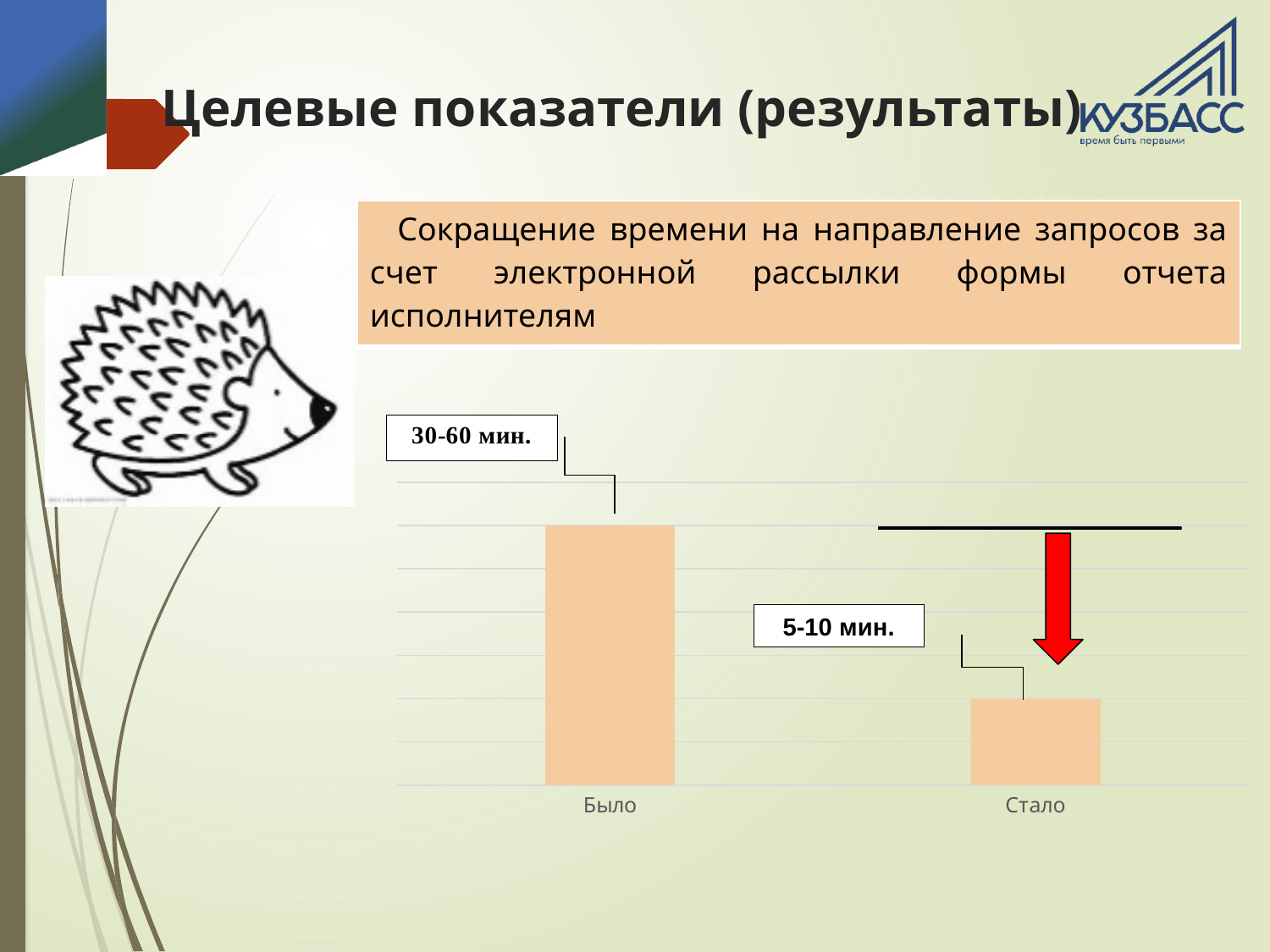
How many categories are shown on the x axis of the chart? 2 What value is labelled for the "Было" bar? 30-60 мин. What are the two category labels on the x axis of the chart? Было, Стало Which bar is taller, "Было" or "Стало"? Было What kind of chart is shown on the slide? bar chart What is the title of the slide containing the chart? Целевые показатели (результаты) What value is labelled for the "Стало" bar? 5-10 мин. Which category has the tallest bar? Было Do the bar values rise or fall from "Было" to "Стало"? fall Which category has the shortest bar? Стало